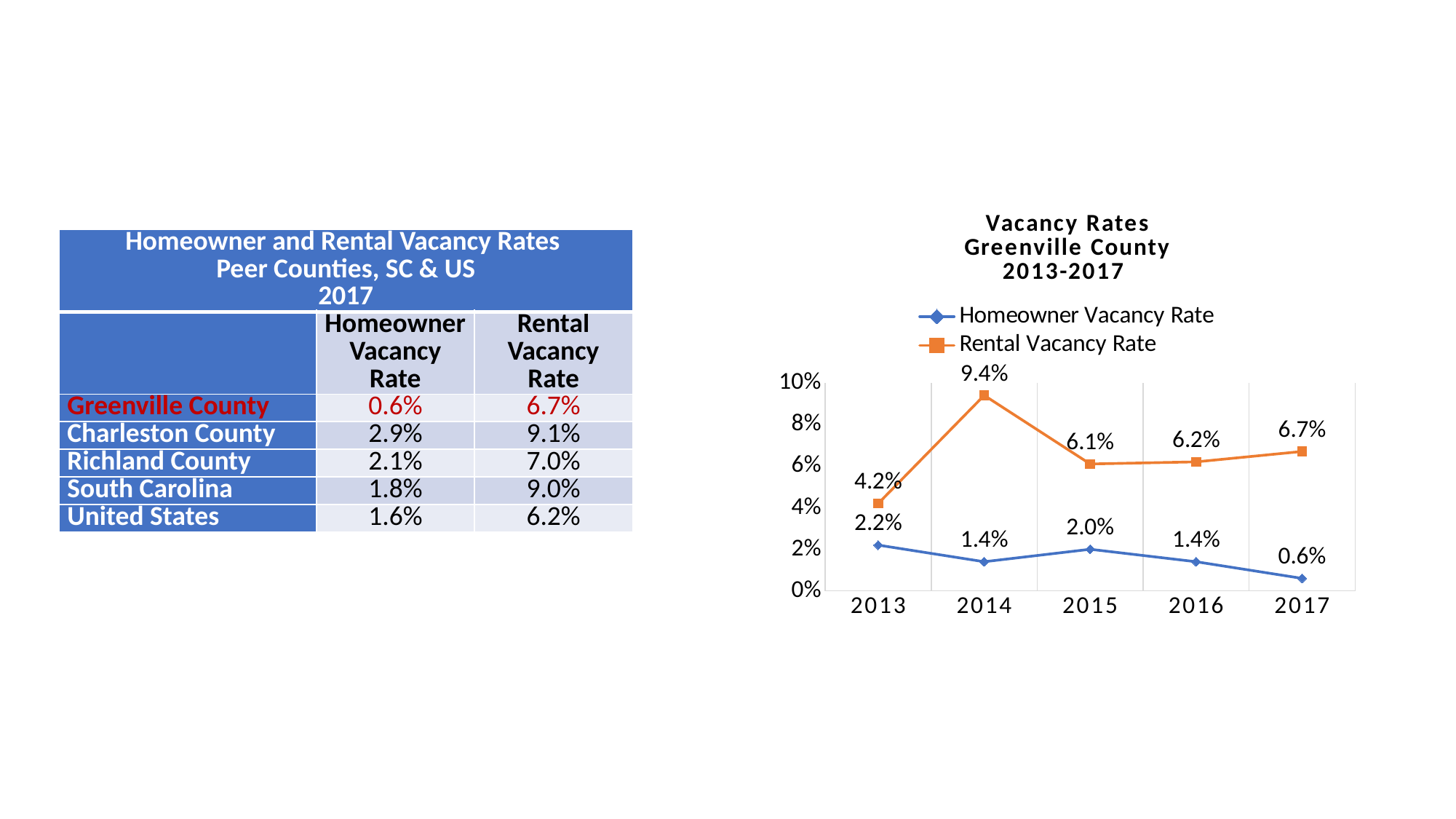
In the Vacancy Rates Greenville County 2013-2017 chart, did the Rental Vacancy Rate rise or fall from 2015 to 2017? Rise In the Vacancy Rates Greenville County 2013-2017 chart, how many series does the legend list? 2 What kind of chart is the Vacancy Rates Greenville County 2013-2017 chart? Line chart In the Vacancy Rates Greenville County 2013-2017 chart, what was the Rental Vacancy Rate in 2014? 9.4% In the Vacancy Rates Greenville County 2013-2017 chart, which year had the highest Rental Vacancy Rate? 2014 In the Vacancy Rates Greenville County 2013-2017 chart, which year had the lowest Homeowner Vacancy Rate? 2017 In the Vacancy Rates Greenville County 2013-2017 chart, what was the Homeowner Vacancy Rate in 2013? 2.2% In the Vacancy Rates Greenville County 2013-2017 chart, how many years are plotted on the x axis? 5 In the Vacancy Rates Greenville County 2013-2017 chart, was the Homeowner Vacancy Rate higher in 2013 or in 2015? 2013 In the Vacancy Rates Greenville County 2013-2017 chart, what was the Homeowner Vacancy Rate in 2017? 0.6% In the Vacancy Rates Greenville County 2013-2017 chart, what is the difference between the Rental Vacancy Rate in 2014 and in 2015? 3.3% In the Vacancy Rates Greenville County 2013-2017 chart, what is the difference between the Rental Vacancy Rate and the Homeowner Vacancy Rate in 2017? 6.1%